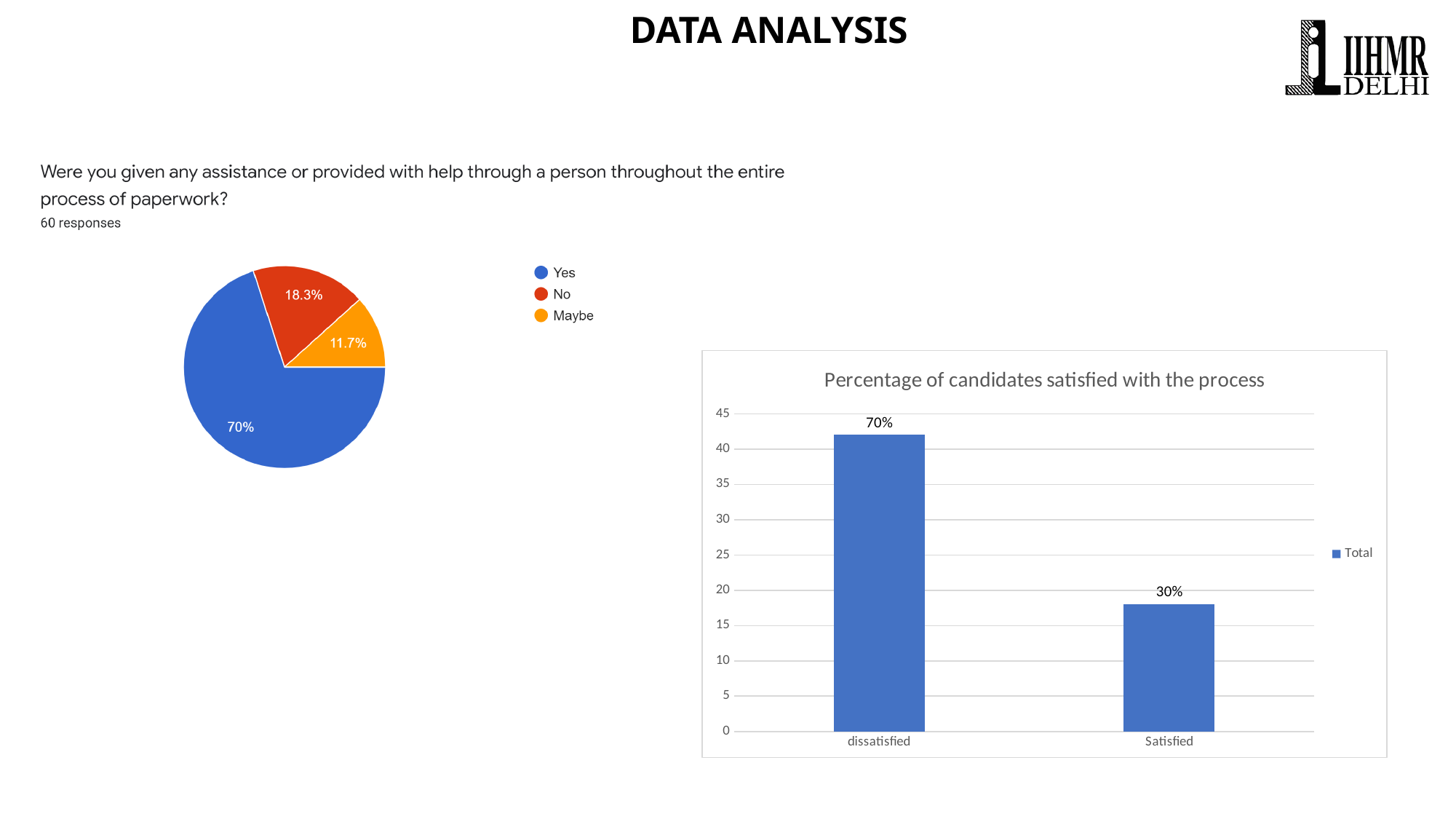
In the pie chart on the left, how many slices are there? 3 In the pie chart on the left, what share of responses is 'Yes'? 70% In the pie chart on the left, what share of responses is 'Maybe'? 11.7% In the pie chart on the left, what is the difference between the 'No' and 'Maybe' shares? 6.6% In the chart titled 'Percentage of candidates satisfied with the process', what is the data label for 'dissatisfied'? 70% What kind of chart is the one titled 'Percentage of candidates satisfied with the process'? bar chart In the pie chart on the left, which response has the smallest slice? Maybe In the pie chart on the left, what share of responses is 'No'? 18.3% In the chart titled 'Percentage of candidates satisfied with the process', is the bar for 'dissatisfied' greater or less than 40 on the axis? greater In the chart titled 'Percentage of candidates satisfied with the process', what is the data label for 'Satisfied'? 30% In the pie chart on the left, which response has the largest slice? Yes In the chart titled 'Percentage of candidates satisfied with the process', what series does the legend list? Total